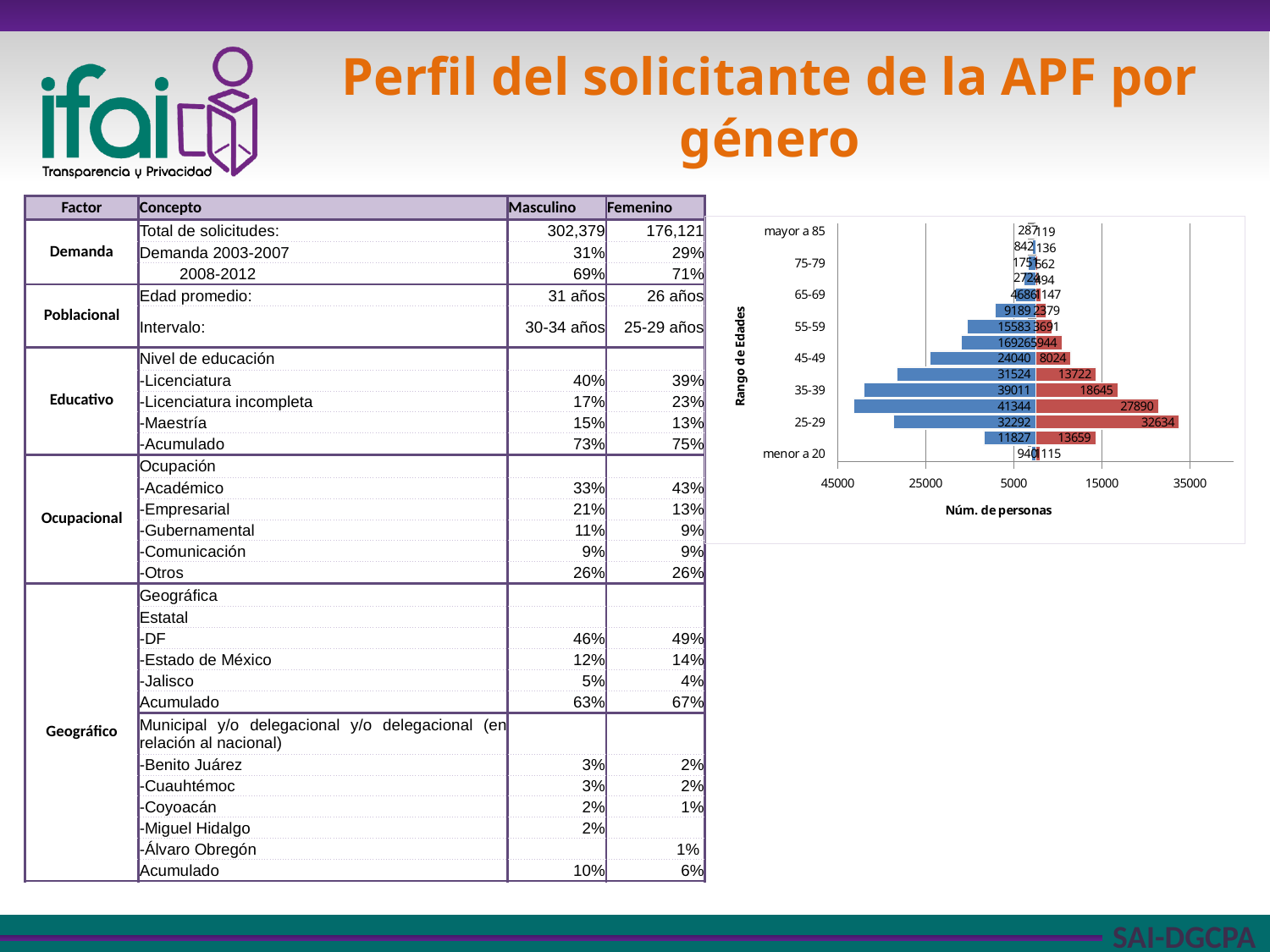
In the chart, what is the value of the red bar for the 25-29 age range? 32634 In the chart, what is the difference between the blue bar and the red bar for the 35-39 age range? 20366 In the chart, which is larger for the 45-49 age range, the blue bar or the red bar? the blue bar In the chart, what is the difference between the blue bar and the red bar for the 45-49 age range? 16016 In the chart, is the value of the blue bar for the 55-59 age range greater or less than 25000? less What is the title of the horizontal axis of the chart? Núm. de personas In the chart, what is the value of the blue bar for the 'mayor a 85' age range? 287 In the chart, what is the value of the blue bar for the 35-39 age range? 39011 What kind of chart is shown on the right side of the slide? bar chart In the chart, what is the value of the red bar for the 'menor a 20' age range? 1115 In the chart, what is the value of the blue bar for the 45-49 age range? 24040 In the chart, what is the value of the red bar for the 35-39 age range? 18645